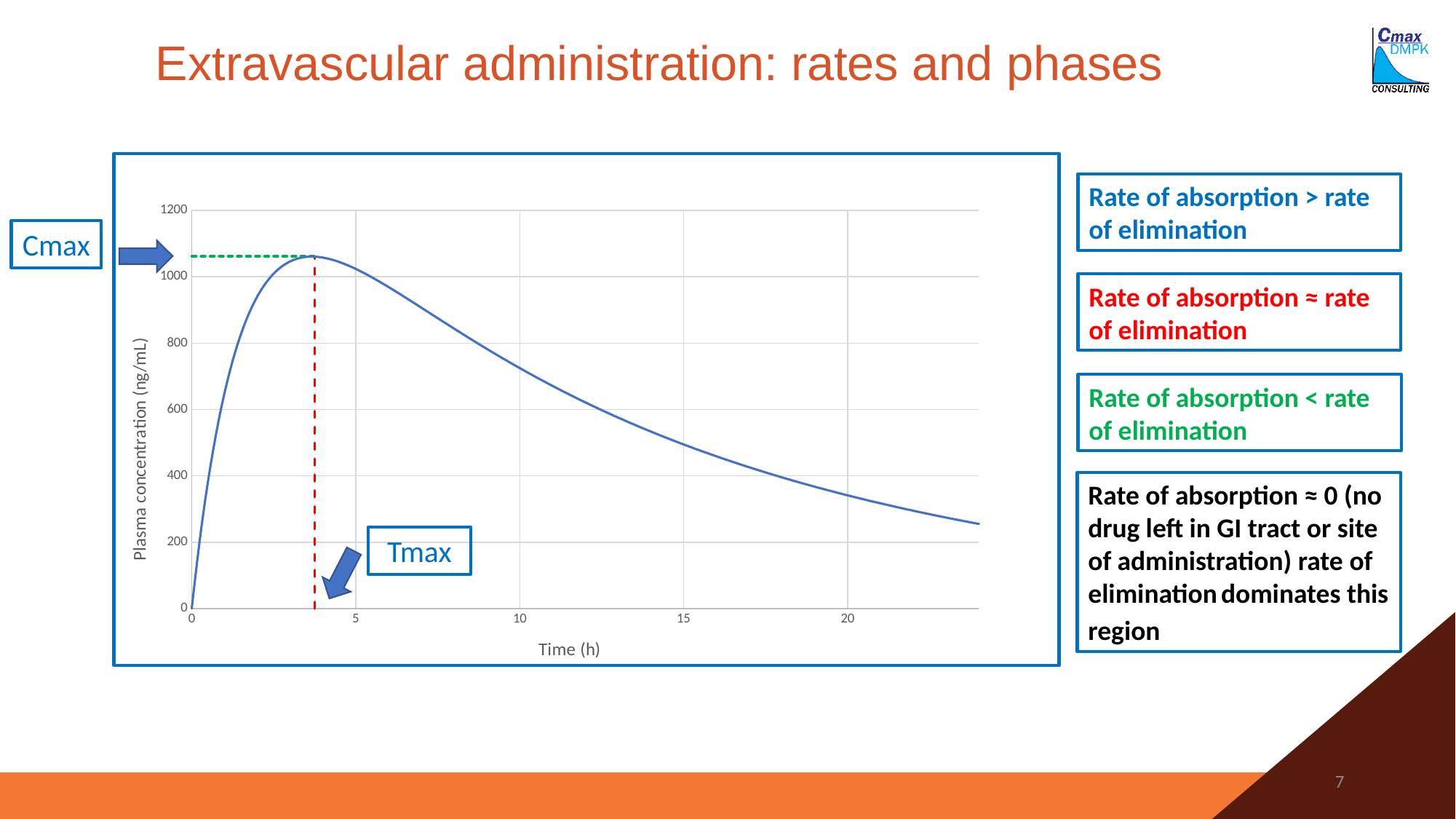
What kind of chart is shown on the slide? line chart Is the plasma concentration at 20 h greater or less than 400? less Is the plasma concentration at 10 h greater or less than 800? less Is the time of the peak (Tmax) on the chart greater or less than 5 h? less How does the plasma concentration change along the time axis after Tmax? it falls What is the label of the y axis of the chart? Plasma concentration (ng/mL) What is the label of the x axis of the chart? Time (h) Which is larger, the plasma concentration at 10 h or at 20 h? 10 h